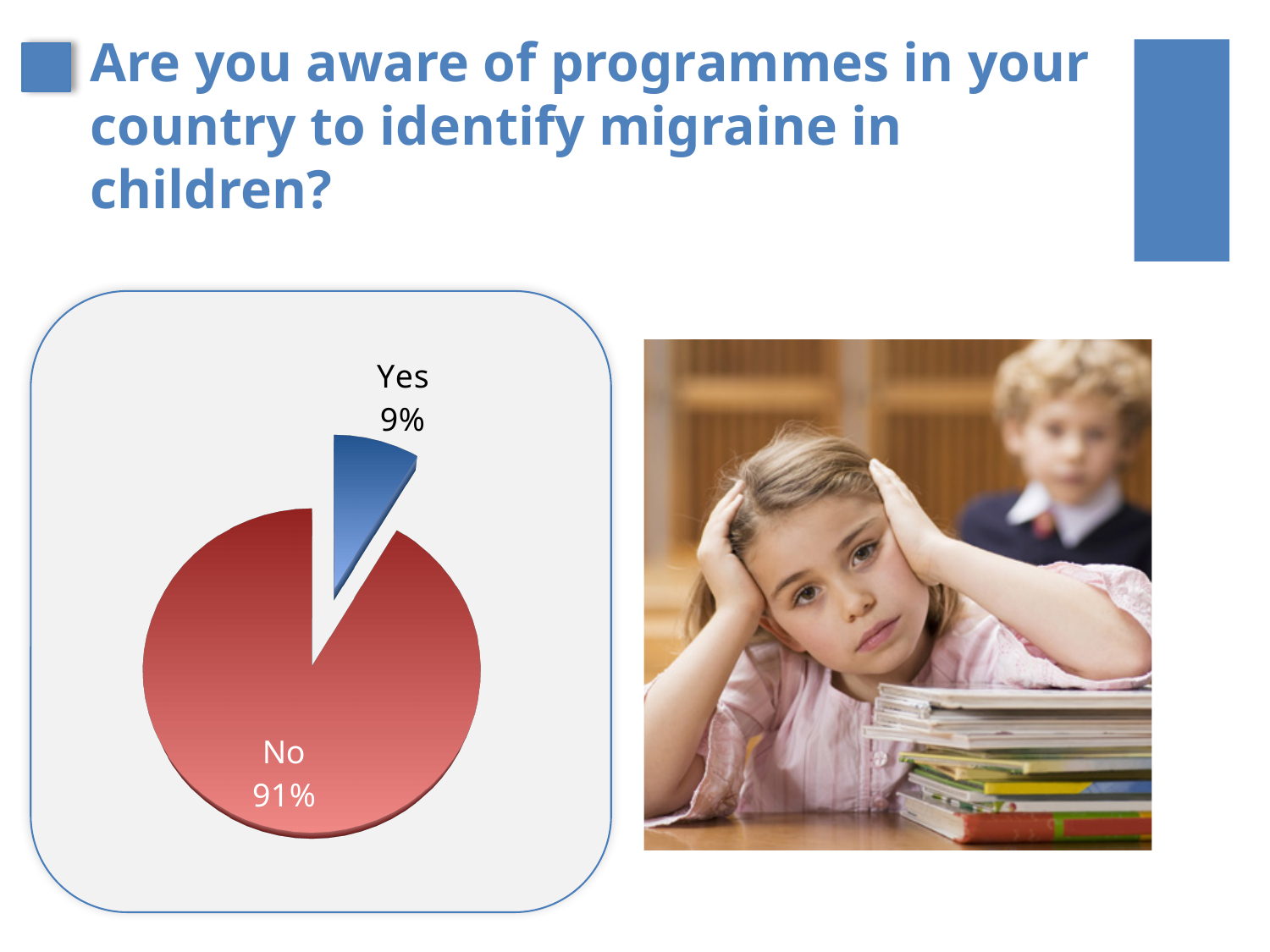
What colour is the "Yes" slice? blue What kind of chart is shown on the slide? pie chart Which response has the largest share of the pie? No Which response has the smallest share of the pie? Yes What is the difference in percentage points between the "No" and "Yes" slices? 82 What colour is the "No" slice? red How many slices does the pie chart have? 2 What share of the pie does the "No" slice represent? 91% What percentage of respondents answered "No"? 91% What percentage of respondents answered "Yes"? 9% Which is larger, the "Yes" slice or the "No" slice? No